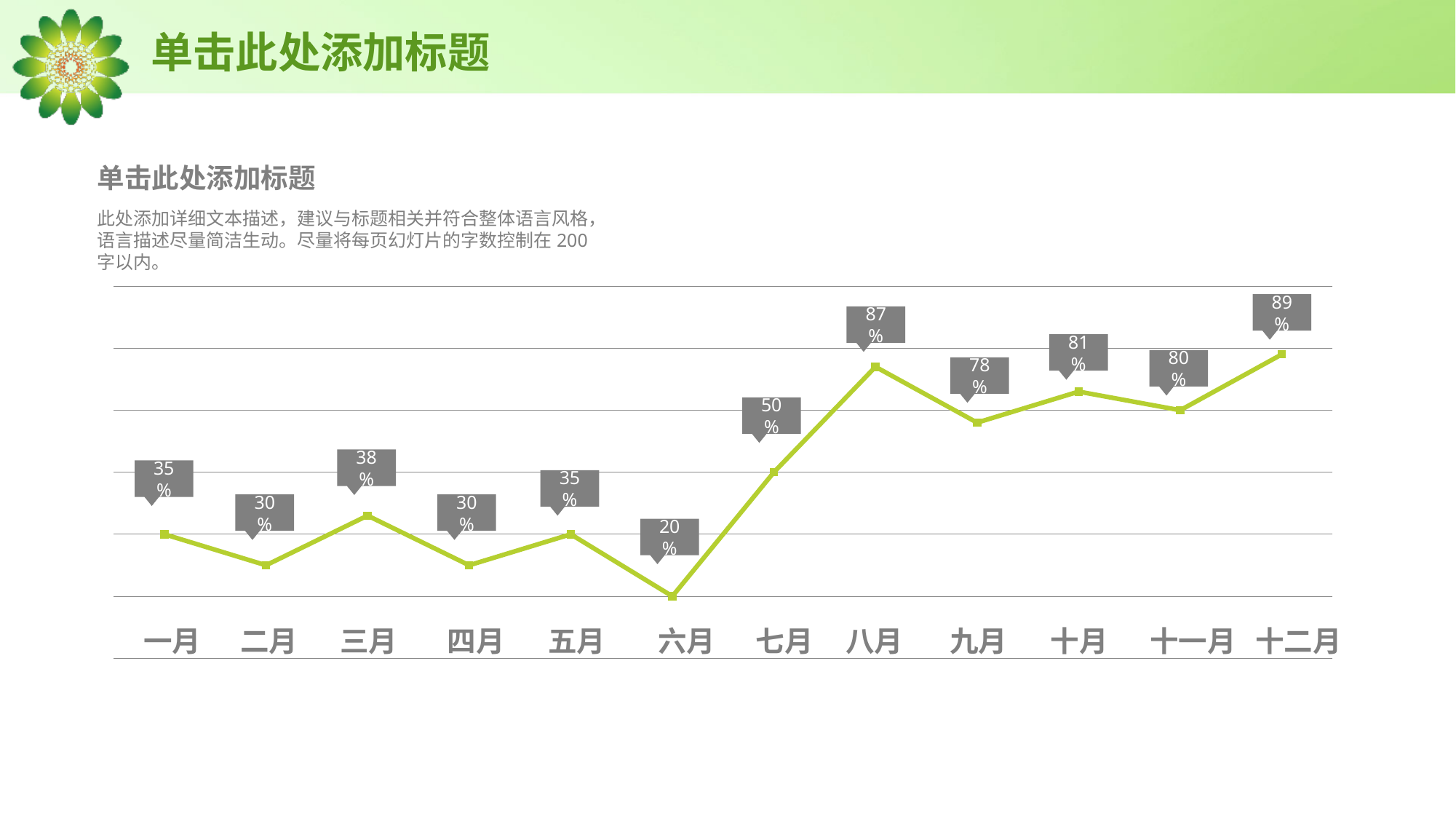
What is the value for 一月 (January)? 35% What is the value for 十月 (October)? 81% Does the value rise or fall from 七月 to 八月? Rise How many months are plotted on the x axis? 12 Which is larger, the value for 三月 or the value for 五月? 三月 What is the difference between the values for 八月 and 七月? 37% Which month has the highest value? 十二月 Which month has the lowest value? 六月 Which is larger, the value for 九月 or the value for 十一月? 十一月 What is the value for 七月 (July)? 50% What kind of chart is shown on the slide? Line chart What is the difference between the values for 十二月 and 一月? 54%